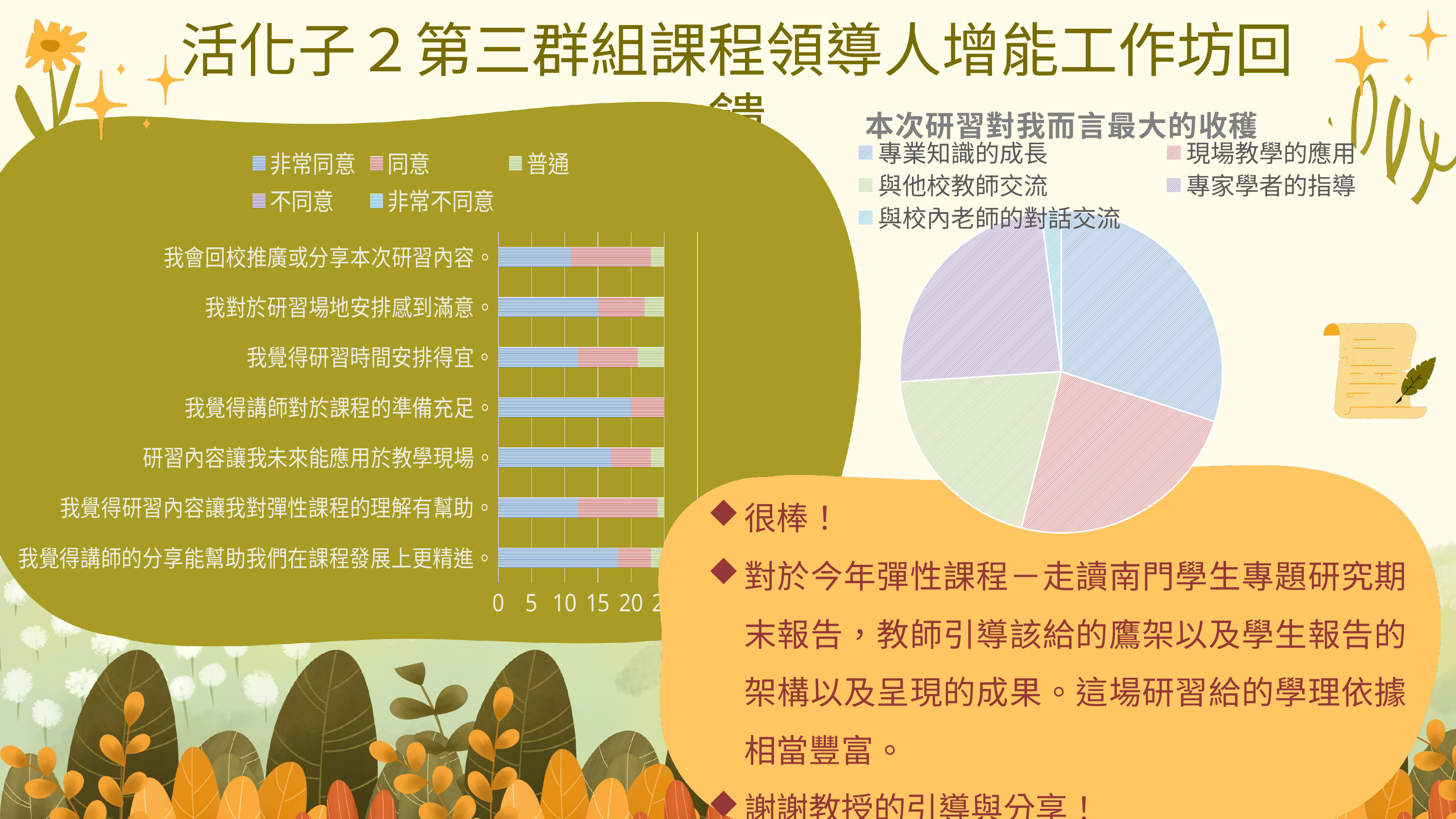
What kind of chart is the chart titled 本次研習對我而言最大的收穫? pie chart In the bar chart on the left, which statement has the highest 非常同意 value? 我覺得講師對於課程的準備充足 In the bar chart on the left, how many series does the legend list? 5 In the pie chart titled 本次研習對我而言最大的收穫, which category has the smallest slice? 與校內老師的對話交流 In the bar chart on the left, is the 非常同意 value for 我會回校推廣或分享本次研習內容 greater or less than 15? less In the bar chart on the left, which series is shown in blue according to the legend? 非常同意 In the bar chart on the left, which statement has the larger 非常同意 value: 我覺得講師對於課程的準備充足 or 我會回校推廣或分享本次研習內容? 我覺得講師對於課程的準備充足 In the pie chart titled 本次研習對我而言最大的收穫, how many slices are there? 5 What is the title of the pie chart on the right side of the slide? 本次研習對我而言最大的收穫 In the bar chart on the left, is the 非常同意 value for 我覺得講師對於課程的準備充足 greater or less than 15? greater What kind of chart is the chart on the left side of the slide? bar chart In the bar chart on the left, how many statements (categories) are plotted? 7